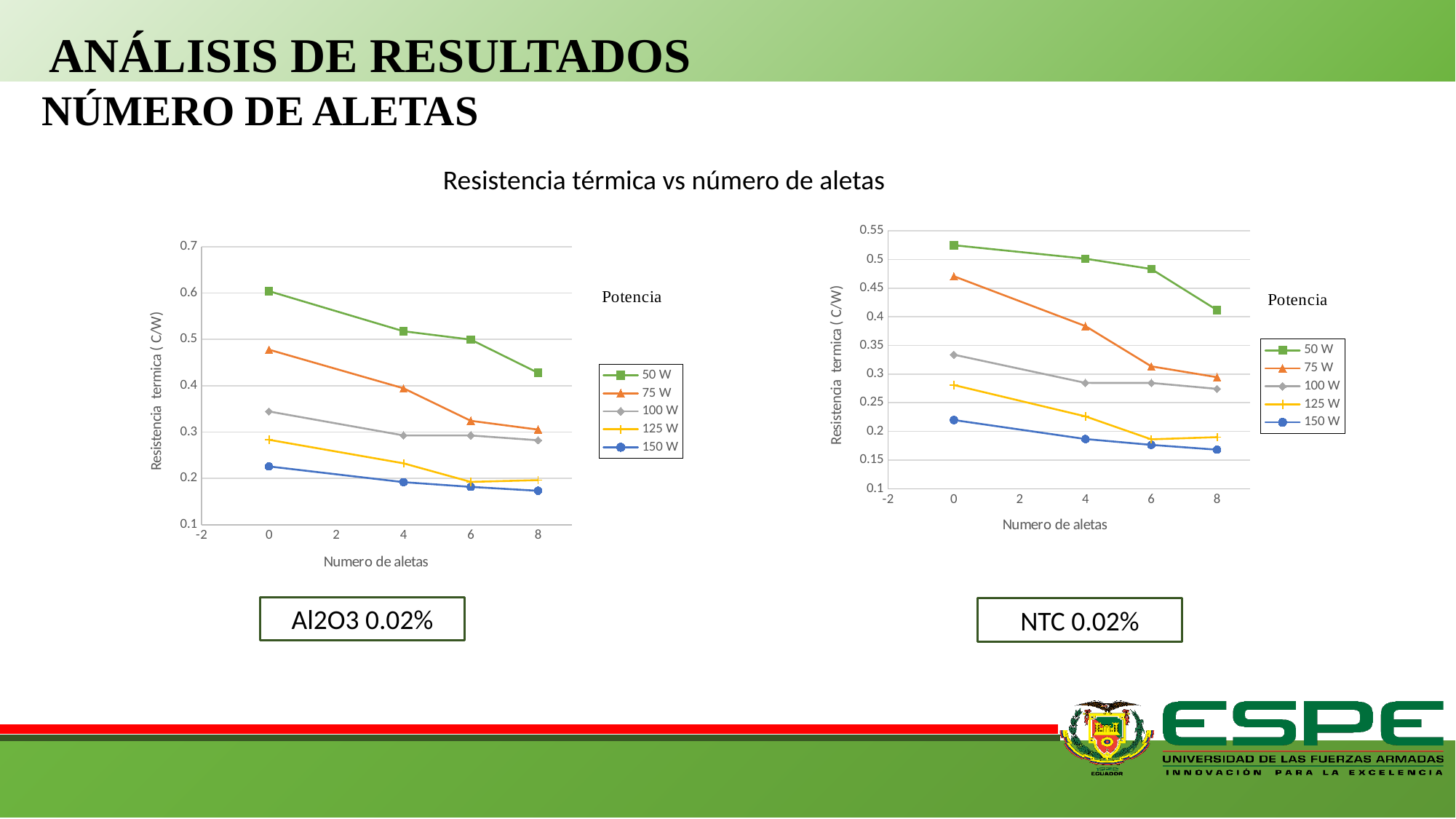
In the left chart (Al2O3 0.02%), does the 75 W series rise or fall as the number of aletas increases? Fall In the left chart (Al2O3 0.02%), how many data points does the 50 W series have? 4 What is the title of the legend in the left chart (Al2O3 0.02%)? Potencia In the left chart (Al2O3 0.02%), is the value for 150 W at 8 aletas greater or less than 0.2? less In the left chart (Al2O3 0.02%), which series has the lowest thermal resistance at 0 aletas? 150 W How many series does the legend of the right chart (NTC 0.02%) list? 5 In the right chart (NTC 0.02%), which is larger at 6 aletas: the 100 W value or the 125 W value? 100 W In the right chart (NTC 0.02%), is the value for 75 W at 4 aletas greater or less than 0.35? greater In the left chart (Al2O3 0.02%), is the value for 50 W at 0 aletas greater or less than 0.5? greater In the right chart (NTC 0.02%), which series has the highest thermal resistance at 0 aletas? 50 W What type of chart is the left chart (Al2O3 0.02%)? Line chart